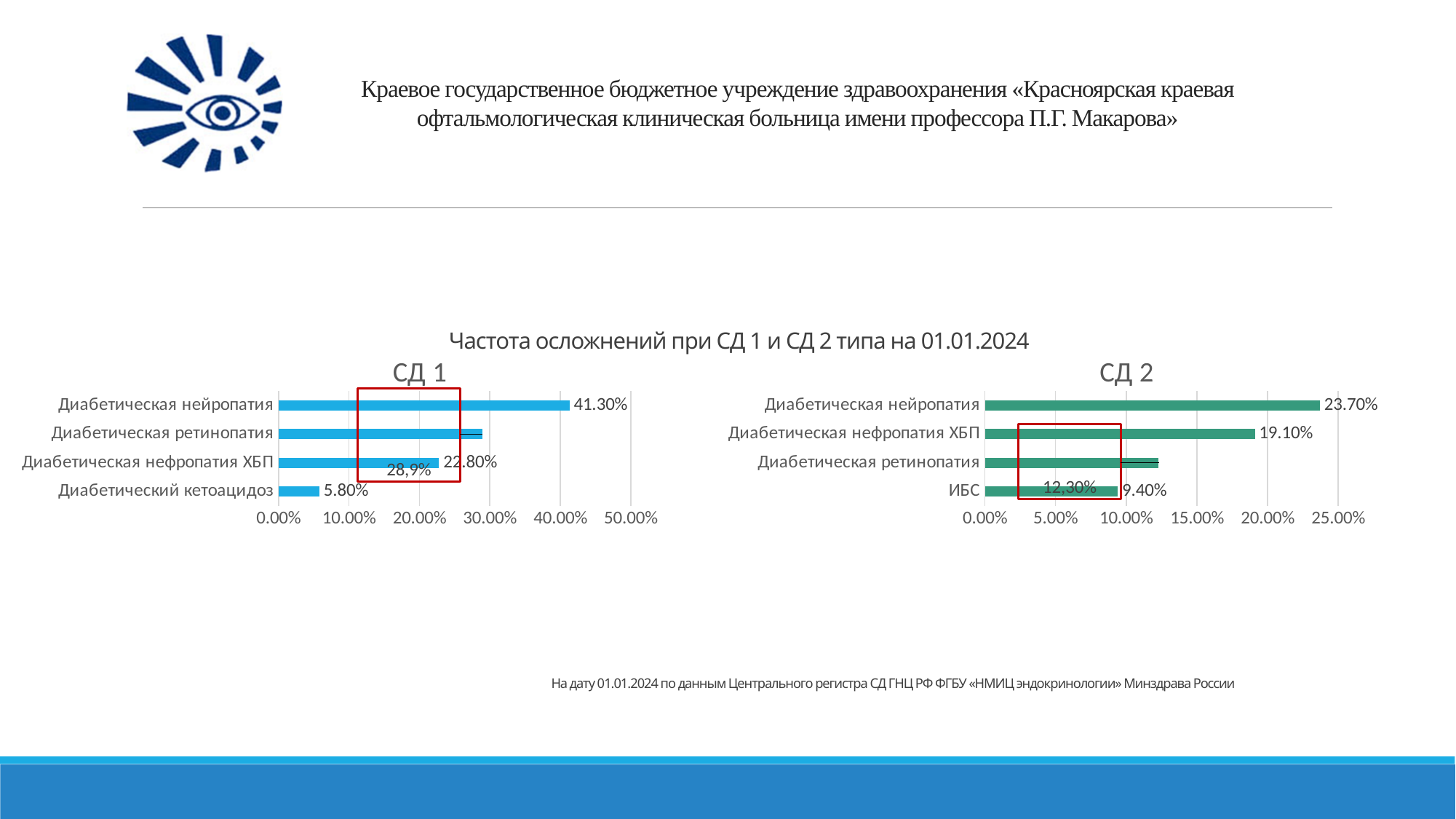
In the СД 2 chart, which is larger: Диабетическая нефропатия ХБП or ИБС? Диабетическая нефропатия ХБП In the СД 1 chart, what is the value for Диабетический кетоацидоз? 5.80% In the СД 1 chart, what is the value for Диабетическая нейропатия? 41.30% In the СД 2 chart, what is the difference between Диабетическая нейропатия and Диабетическая нефропатия ХБП? 4.60% In the СД 2 chart, what is the value for Диабетическая нейропатия? 23.70% In the СД 1 chart, what is the difference between Диабетическая нейропатия and Диабетическая нефропатия ХБП? 18.50% In the СД 1 chart, what kind of chart is used? Bar chart In the СД 2 chart, what is the value for ИБС? 9.40% In the СД 1 chart, which category has the lowest value? Диабетический кетоацидоз In the СД 1 chart, which category has the highest value? Диабетическая нейропатия In the СД 1 chart, how many categories are shown? 4 In the СД 2 chart, is the value for Диабетическая ретинопатия greater or less than 10.00%? greater